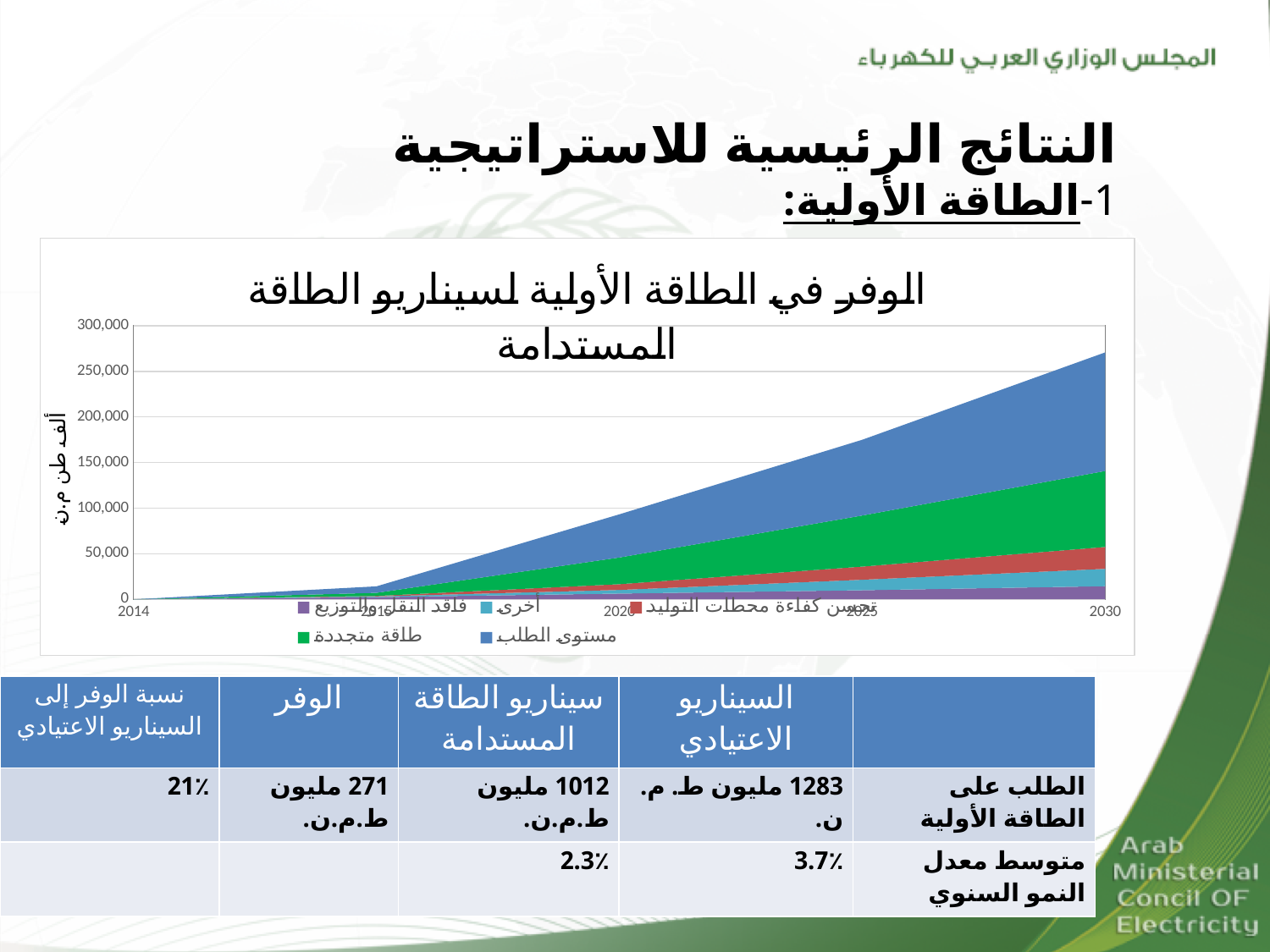
Is the total stacked value in 2030 greater or less than 250,000? greater What is the title of the chart? الوفر في الطاقة الأولية لسيناريو الطاقة المستدامة What kind of chart is shown on the slide? area chart Is the total stacked value in 2020 greater or less than 100,000? less Which series contributes the largest share of the stacked total in 2030? مستوى الطلب Is the total stacked value in 2014 greater or less than 50,000? less How many series does the chart's legend list? 5 In 2030, which series has the larger band: طاقة متجددة or تحسين كفاءة محطات التوليد? طاقة متجددة What is the label on the chart's vertical axis? ألف طن م.ن. Do the total savings in the chart rise or fall from 2014 to 2030? rise